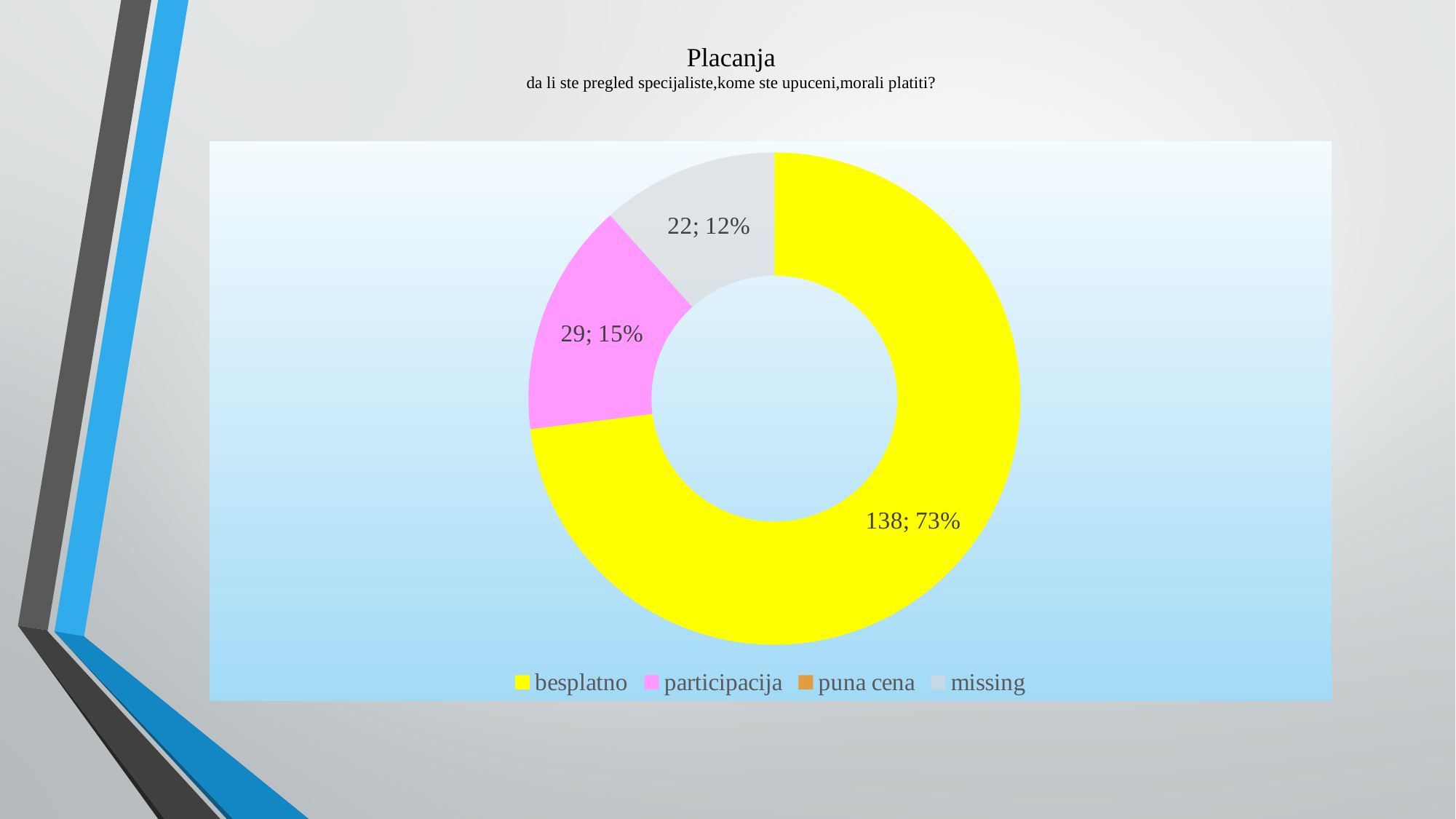
Which category has the largest slice? besplatno Which has the larger count, participacija or missing? participacija What is the count for missing? 22 What share of the chart does besplatno represent? 73% What is the difference between the counts for besplatno and participacija? 109 How many categories does the legend list? 4 What share of the chart does participacija represent? 15% What is the title of the chart? Placanja What is the count for besplatno? 138 What share of the chart does missing represent? 12% What is the count for participacija? 29 What kind of chart is shown on the slide? doughnut (pie) chart